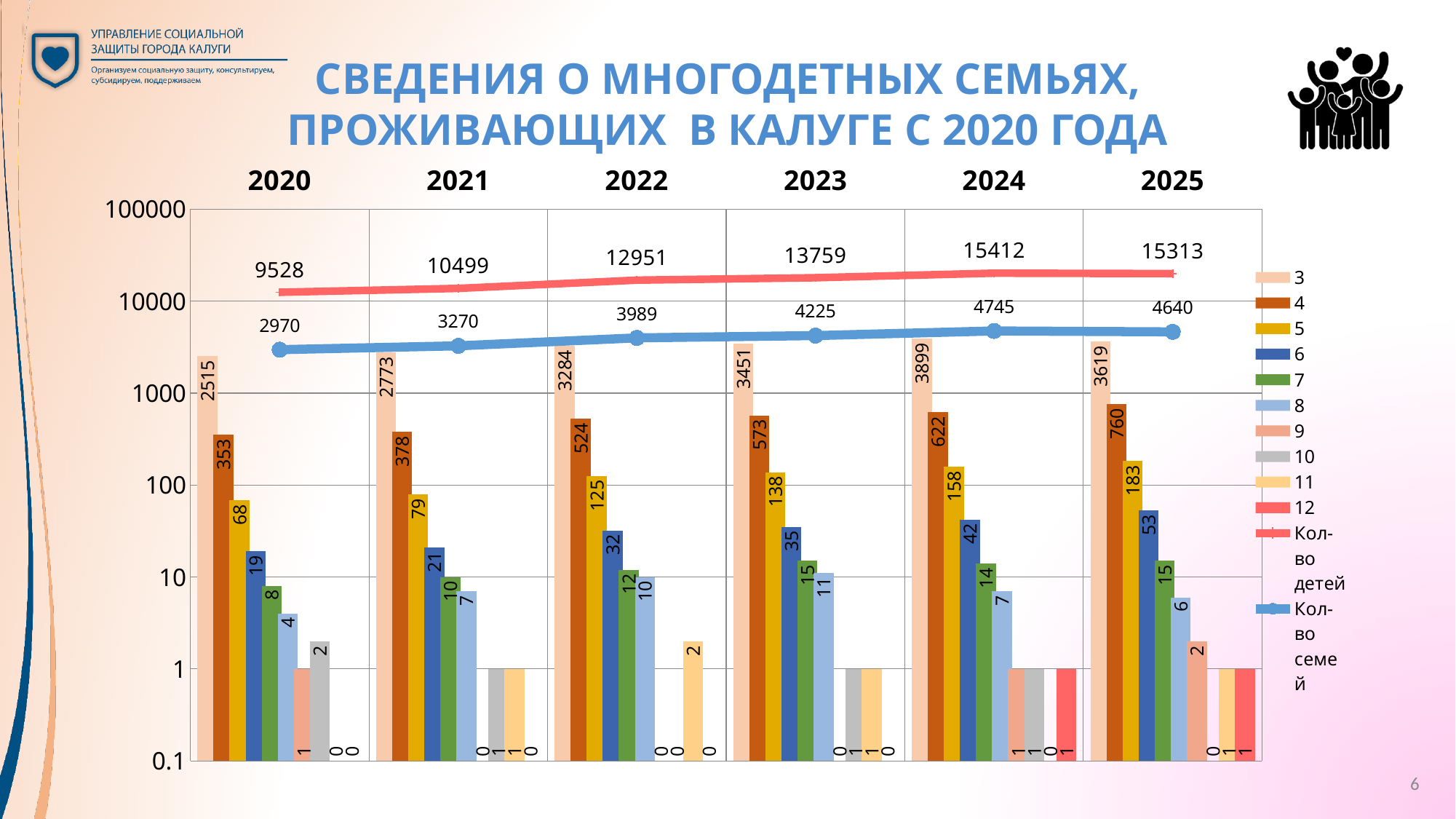
What kind of chart is shown on the slide? Combined bar and line chart In which year is the 'Кол-во семей' line lowest? 2020 Does the 'Кол-во детей' line rise or fall from 2020 to 2024? Rise What is the value of the bar for series '3' in 2023? 3451 What is the value of the bar for series '5' in 2025? 183 In which year is the 'Кол-во детей' line highest? 2024 How many years are shown on the x axis? 6 What is the difference between the 'Кол-во семей' values for 2025 and 2020? 1670 What is the value of the 'Кол-во детей' line for 2024? 15412 How many entries does the legend list? 12 What is the value of the 'Кол-во семей' line for 2022? 3989 Which is larger: the bar for series '4' in 2025 or in 2024? 2025